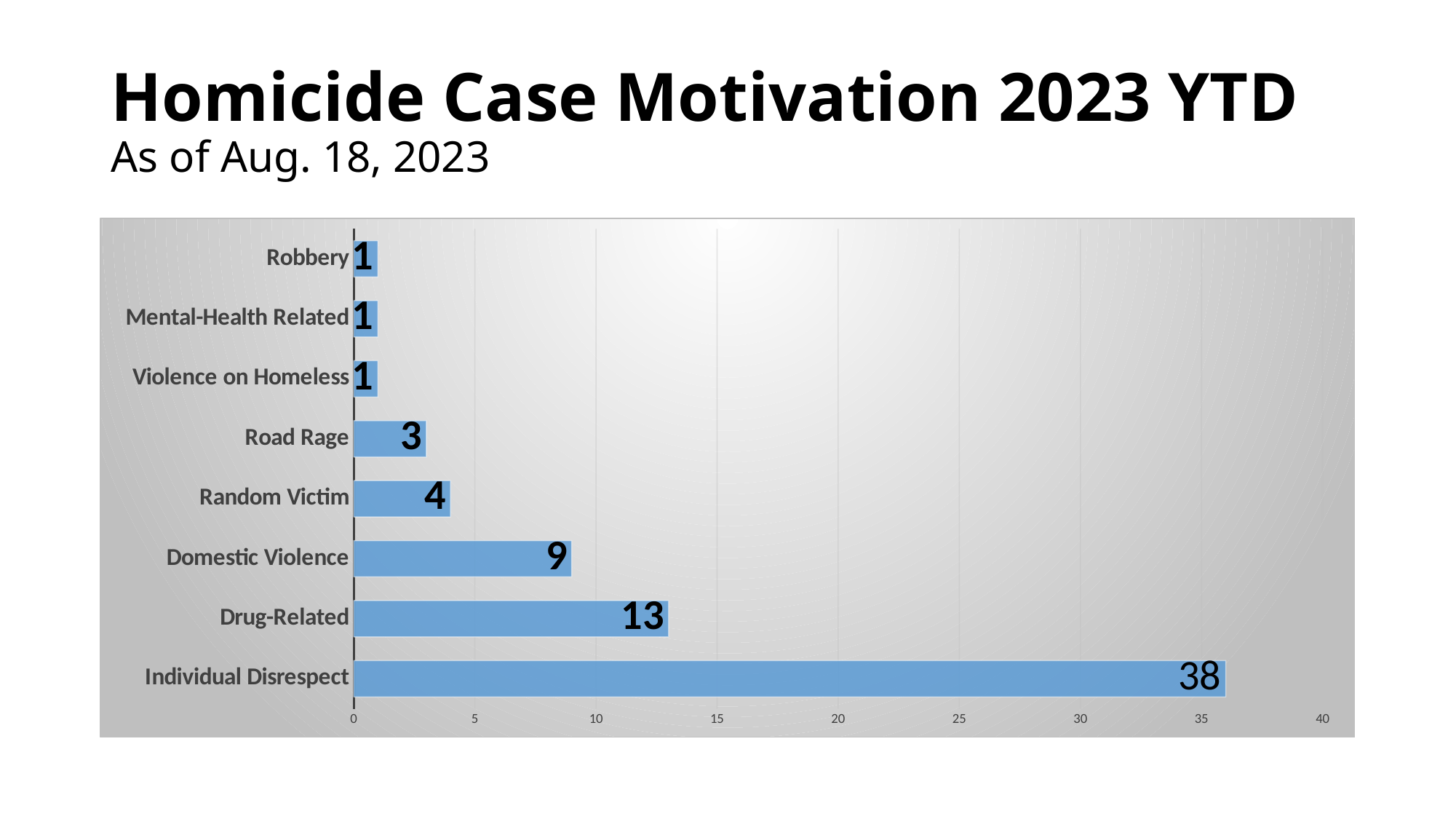
What is the value for Domestic Violence? 9 What kind of chart is shown on the slide? bar chart What is the difference between the values for Random Victim and Road Rage? 1 What is the value for Individual Disrespect? 38 What is the value for Drug-Related? 13 What is the value for Road Rage? 3 Is the value for Individual Disrespect greater or less than 30? greater How many categories are shown in the chart? 8 What is the title of the chart on the slide? Homicide Case Motivation 2023 YTD Which is larger, the value for Random Victim or the value for Road Rage? Random Victim What is the difference between the values for Drug-Related and Domestic Violence? 4 Which category has the highest value? Individual Disrespect